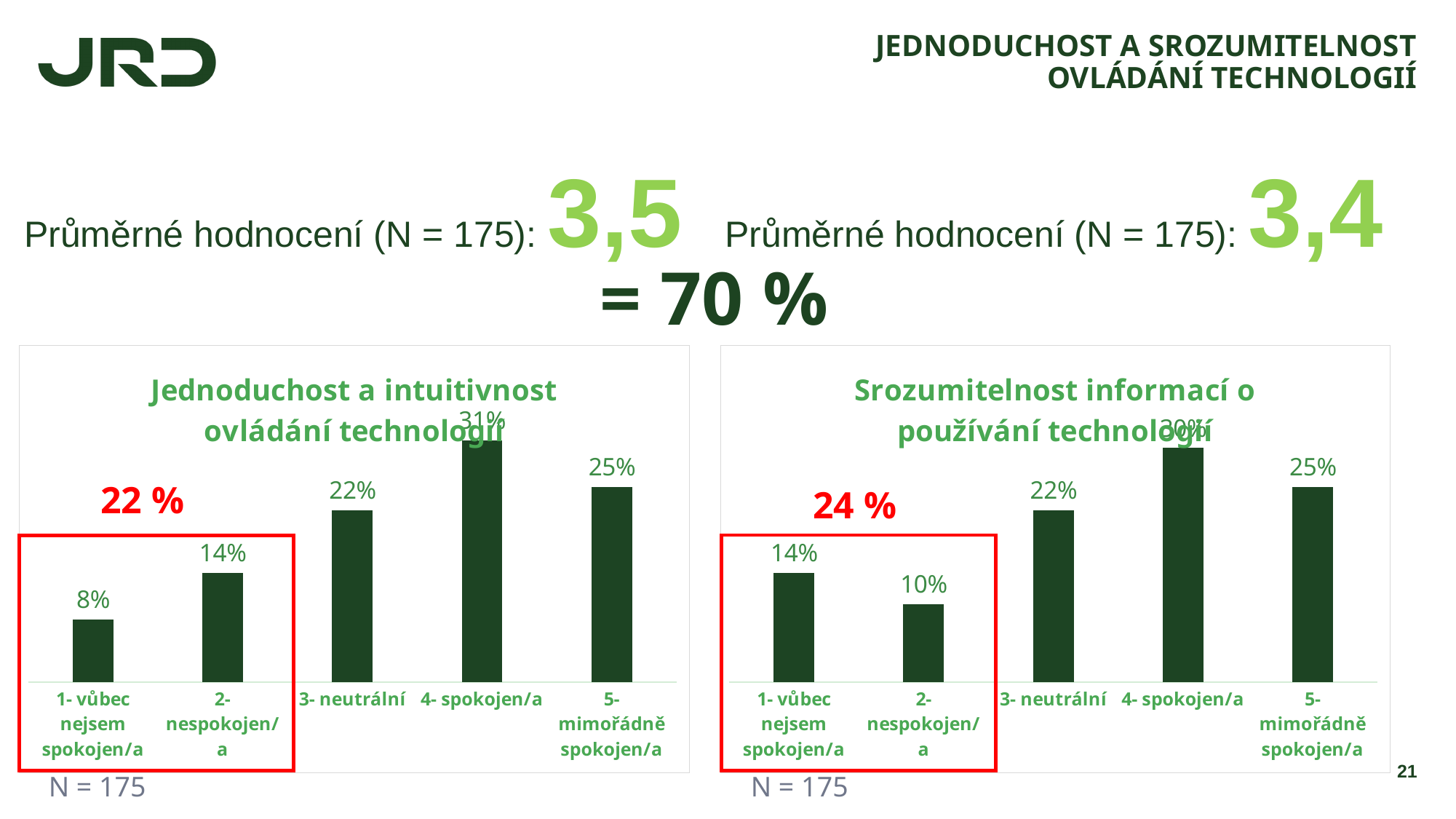
In the right chart, which is larger: the value for "1- vůbec nejsem spokojen/a" or the value for "2- nespokojen/a"? 1- vůbec nejsem spokojen/a In the chart titled "Jednoduchost a intuitivnost ovládání technologií", what is the value for "1- vůbec nejsem spokojen/a"? 8% In the chart titled "Srozumitelnost informací o používání technologií", what is the value for "5- mimořádně spokojen/a"? 25% In the right chart, which category has the highest value? 4- spokojen/a In the left chart, which category has the lowest value? 1- vůbec nejsem spokojen/a In the right chart, which category has the lowest value? 2- nespokojen/a In the left chart, what is the difference between the values for "3- neutrální" and "1- vůbec nejsem spokojen/a"? 14% How many categories does the right chart show? 5 In the chart titled "Jednoduchost a intuitivnost ovládání technologií", what is the value for "2- nespokojen/a"? 14% In the left chart, which category has the highest value? 4- spokojen/a In the chart titled "Srozumitelnost informací o používání technologií", what is the value for "2- nespokojen/a"? 10% What type of chart is the left chart? Bar chart